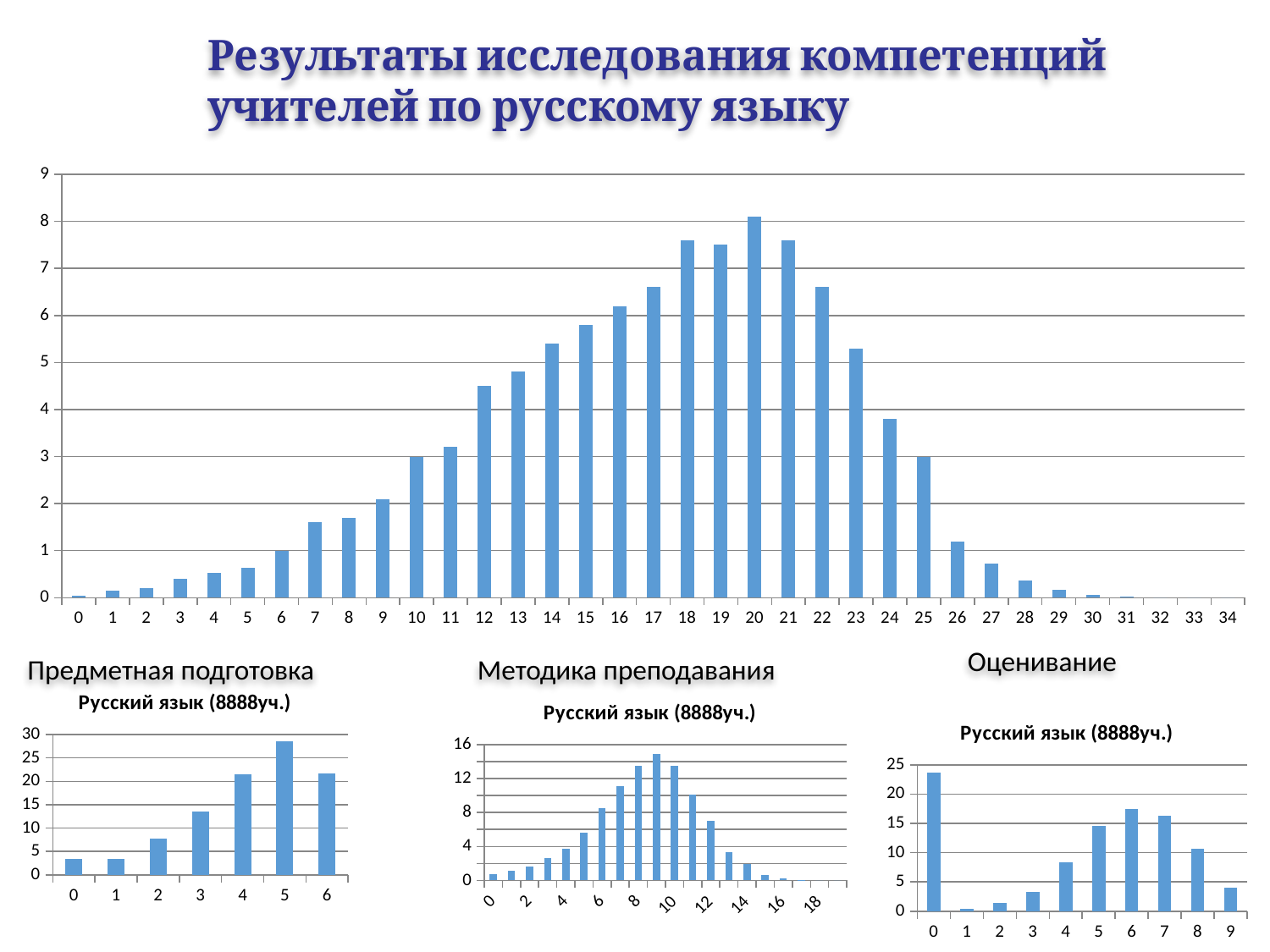
What type of chart is the 'Оценивание' chart? bar chart On the 'Методика преподавания' chart, which category has the highest bar? 9 On the 'Предметная подготовка' chart, which category has the highest bar? 5 On the large chart at the top of the slide, which category has the highest bar? 20 On the large chart at the top of the slide, is the value for category 12 greater or less than 4? greater On the large chart at the top of the slide, how many categories are shown on the x axis? 35 On the 'Предметная подготовка' chart, which is larger, the value for category 2 or category 3? 3 On the 'Оценивание' chart, which category has the lowest bar? 1 On the large chart at the top of the slide, is the value for category 20 greater or less than 8? greater On the 'Предметная подготовка' chart, is the value for category 3 greater or less than 15? less On the large chart at the top of the slide, do the values rise or fall from category 20 to category 30? fall